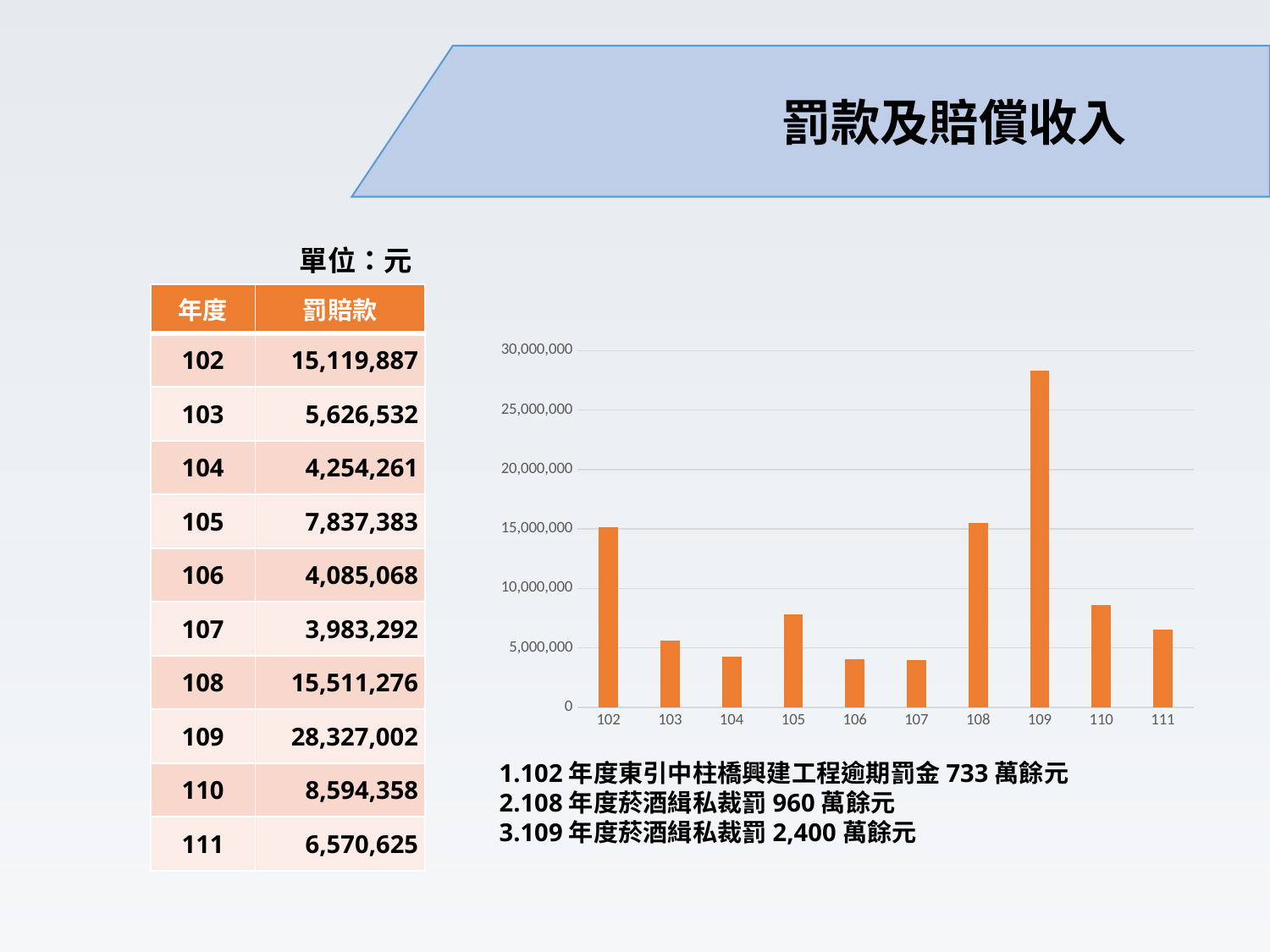
What is the title of the slide containing the chart? 罰款及賠償收入 What is the difference between the values for year 109 and year 108? 12,815,726 According to the slide, what is the 罰賠款 value for year 109? 28,327,002 Which year has the highest bar in the chart? 109 According to the slide, what is the 罰賠款 value for year 111? 6,570,625 According to the slide, what is the 罰賠款 value for year 102? 15,119,887 Which year has the lowest bar in the chart? 107 How many years (categories) are plotted on the x axis of the chart? 10 Is the value for year 109 greater or less than 25,000,000? greater Is the value for year 104 greater or less than 5,000,000? less What type of chart is shown on the slide? bar chart Which is larger, the value for year 108 or the value for year 102? 108